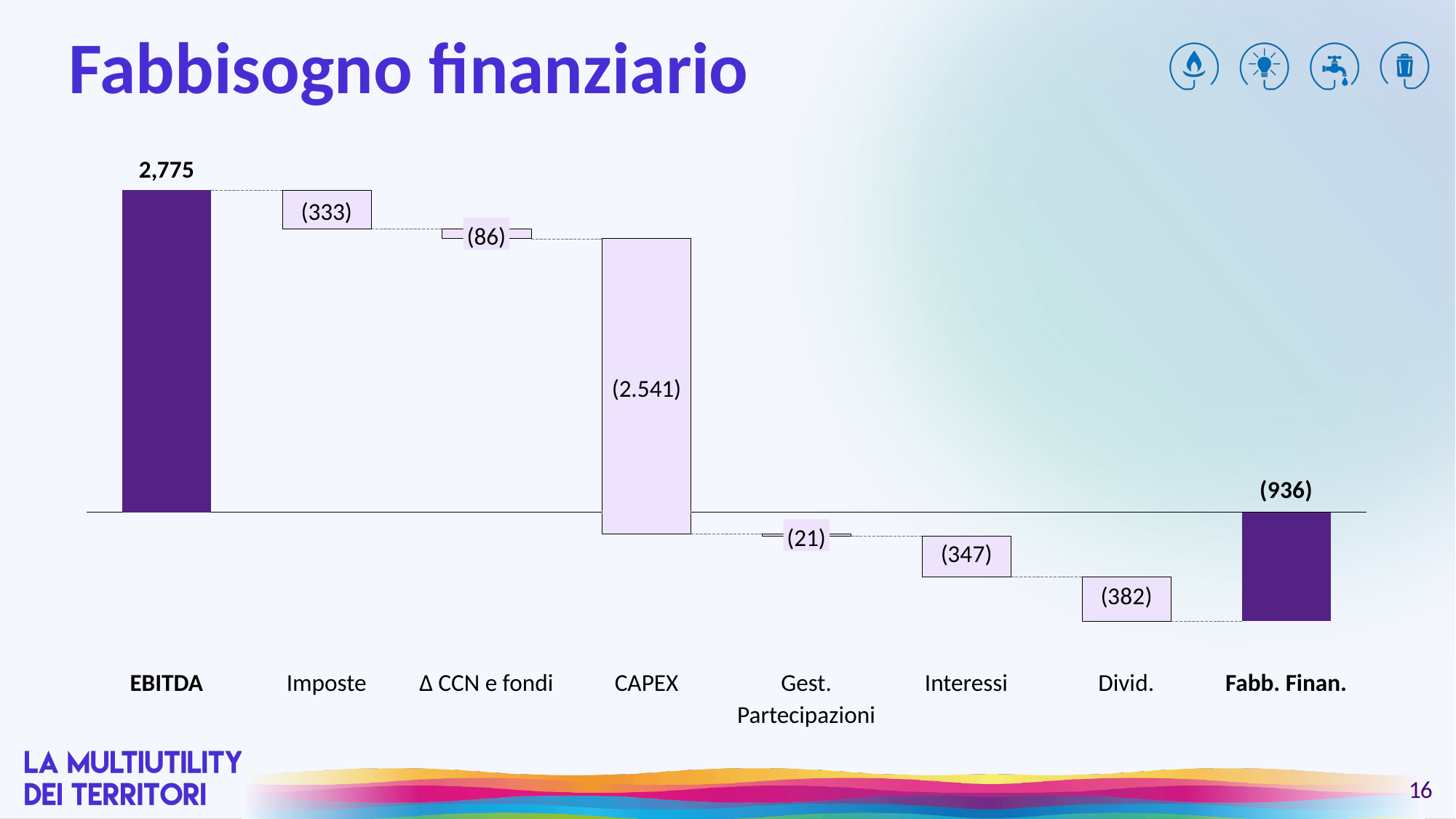
What is the value shown for EBITDA? 2,775 Which category has the largest value in the chart? EBITDA Which category has the smallest value by magnitude in the chart? Gest. Partecipazioni How many categories are shown along the x axis of the chart? 8 What is the value shown for Fabb. Finan.? (936) What is the title of the slide containing the chart? Fabbisogno finanziario What is the value shown for Divid.? (382) What is the value shown for CAPEX? (2.541) What is the value shown for Gest. Partecipazioni? (21) What is the difference in magnitude between Divid. (382) and Interessi (347)? 35 What is the value shown for Imposte? (333) Which is larger in magnitude, Interessi or Divid.? Divid.